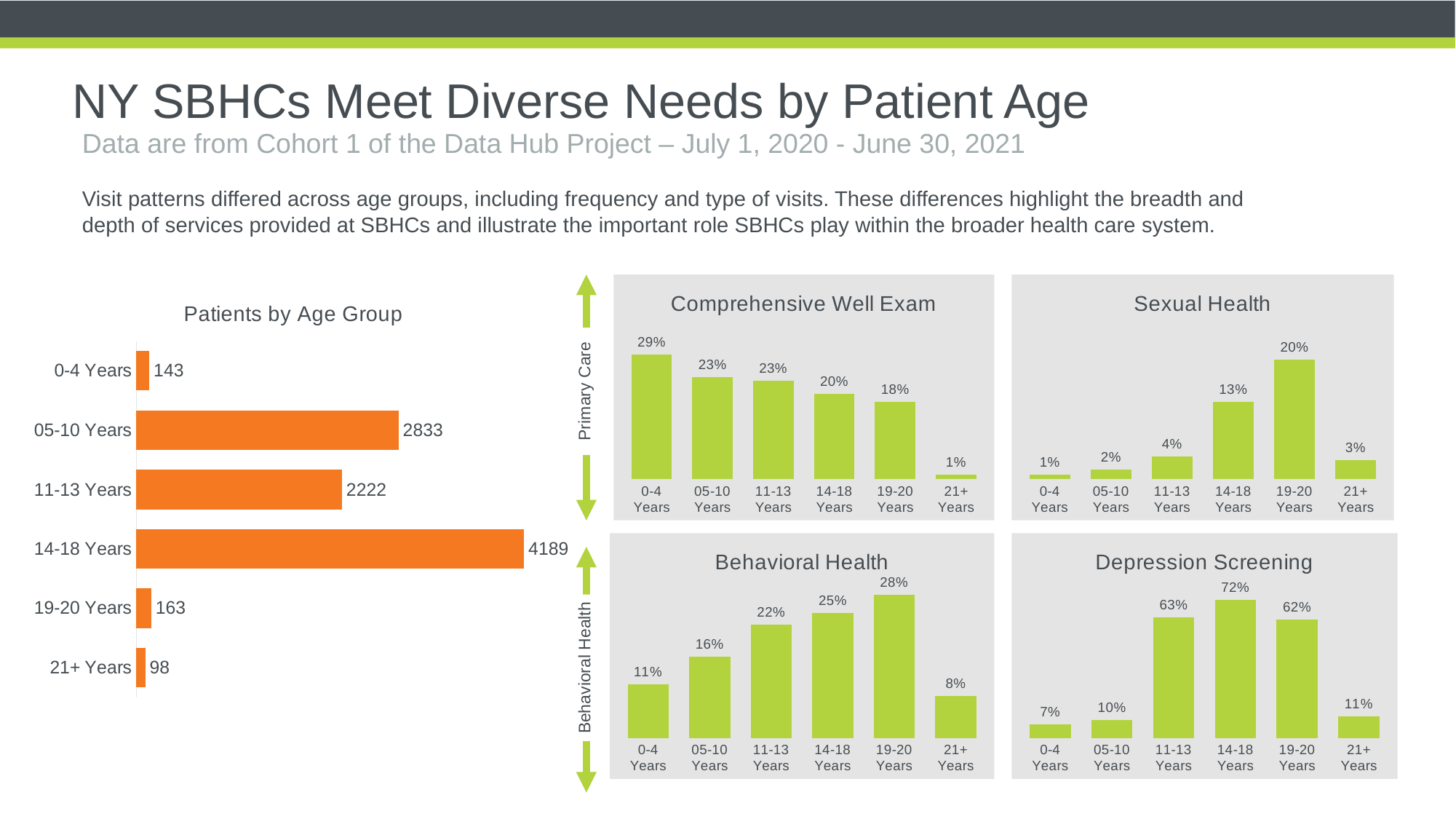
In the 'Patients by Age Group' chart, how many patients are in the 14-18 Years group? 4189 In the 'Sexual Health' chart, which age group has the highest value? 19-20 Years In the 'Comprehensive Well Exam' chart, do the values rise or fall from 0-4 Years to 21+ Years? Fall In the 'Patients by Age Group' chart, which age group has the fewest patients? 21+ Years What kind of chart is 'Patients by Age Group'? Bar chart How many age groups are shown in the 'Behavioral Health' chart? 6 In the 'Patients by Age Group' chart, what is the difference between the 05-10 Years and 11-13 Years values? 611 In the 'Depression Screening' chart, what is the value for 14-18 Years? 72% In the 'Behavioral Health' chart, which is larger, the value for 05-10 Years or 21+ Years? 05-10 Years In the 'Sexual Health' chart, what is the value for 14-18 Years? 13% In the 'Depression Screening' chart, what is the difference between the 14-18 Years and 19-20 Years values? 10% In the 'Comprehensive Well Exam' chart, what is the value for 0-4 Years? 29%